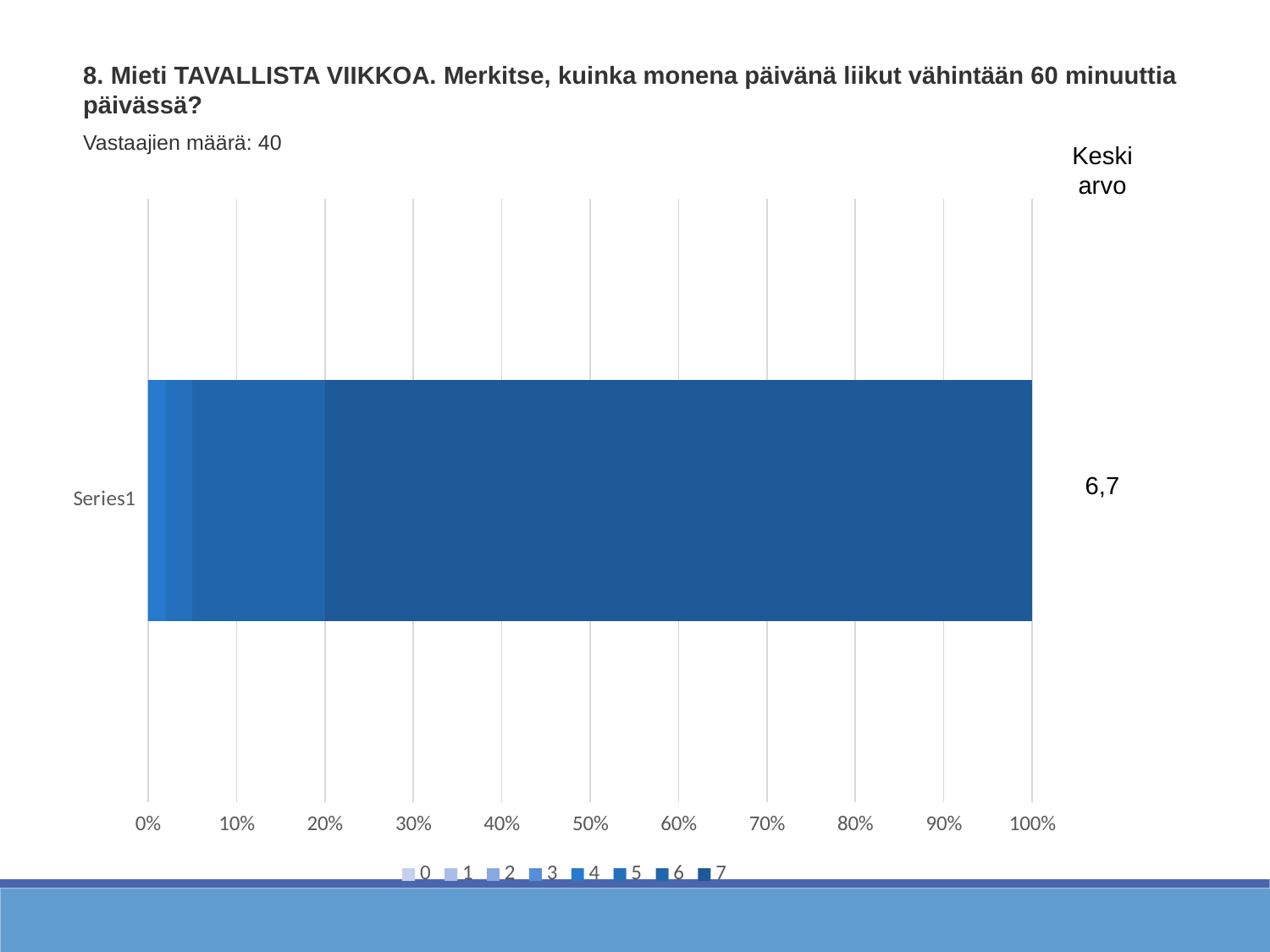
Is the share of the segment for 4 greater or less than 10%? less Which segment is larger in the stacked bar, the one for 6 or the one for 5? 6 How many categories are plotted on the vertical axis? 1 Which legend entry has the largest segment in the stacked bar? 7 What is the mean value (Keskiarvo) shown to the right of the chart? 6,7 Is the share of the segment for 6 greater or less than 20%? less What kind of chart is shown on the slide? bar chart What is the number of respondents (Vastaajien määrä) stated on the slide? 40 Is the share of the segment for 7 greater or less than 50%? greater What is the label of the single category on the vertical axis? Series1 How many series does the legend list? 8